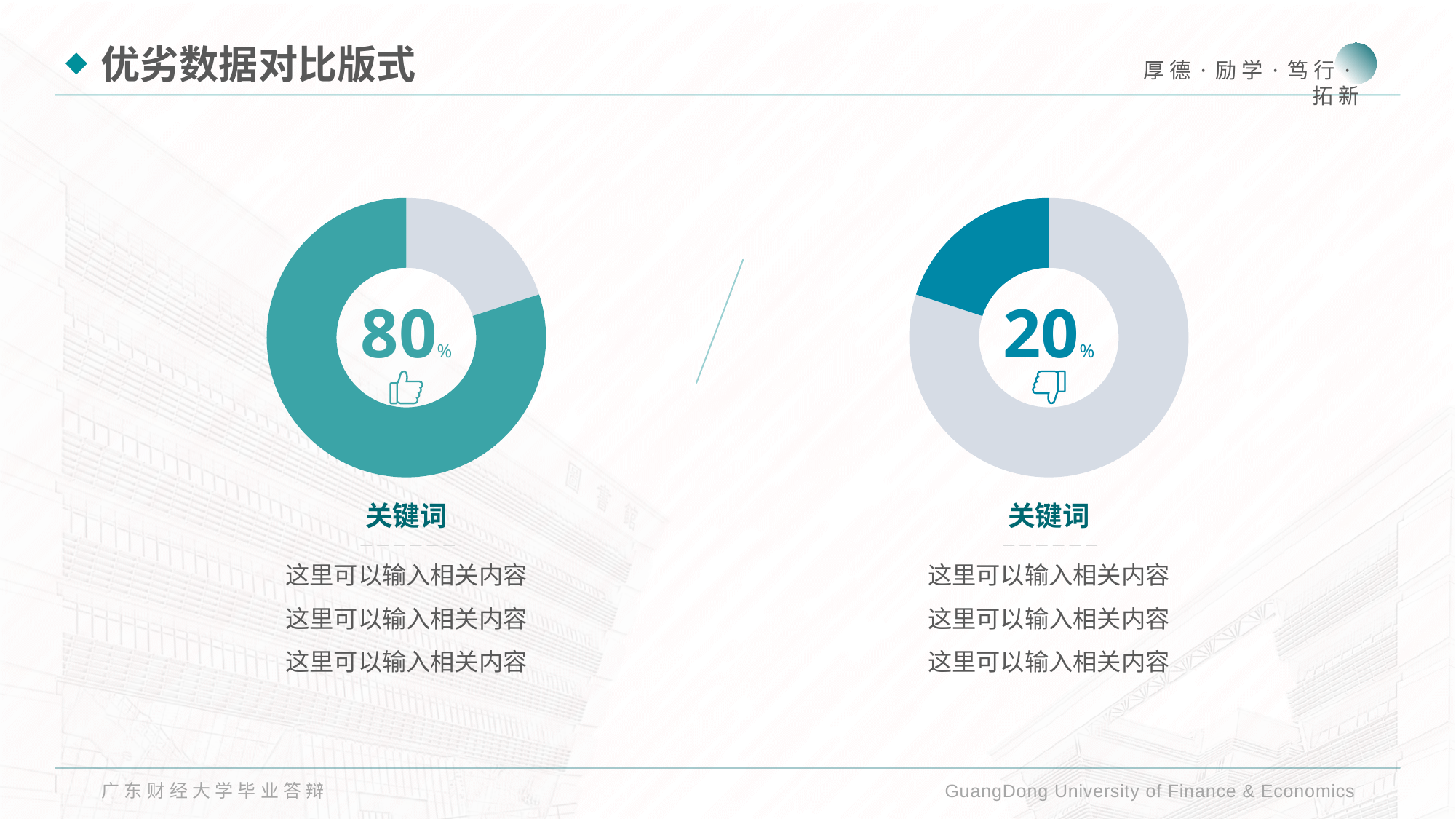
Which chart shows the larger percentage, the left one or the right one? The left one In the right donut chart, what share of the ring is filled with the teal colour? 20% What is the difference between the percentage in the left chart and the percentage in the right chart? 60 percentage points What value is shown in the centre of the right donut chart? 20% What icon appears below the percentage in the left donut chart? A thumbs-up icon How many slices does the right donut chart have? 2 How many slices does the left donut chart have? 2 In the left donut chart, what share of the ring is filled with the teal colour? 80% Is the value shown in the right donut chart greater or less than 50%? less What kind of chart is used on the right side of the slide? Donut chart What kind of chart is used on the left side of the slide? Donut chart What value is shown in the centre of the left donut chart? 80%